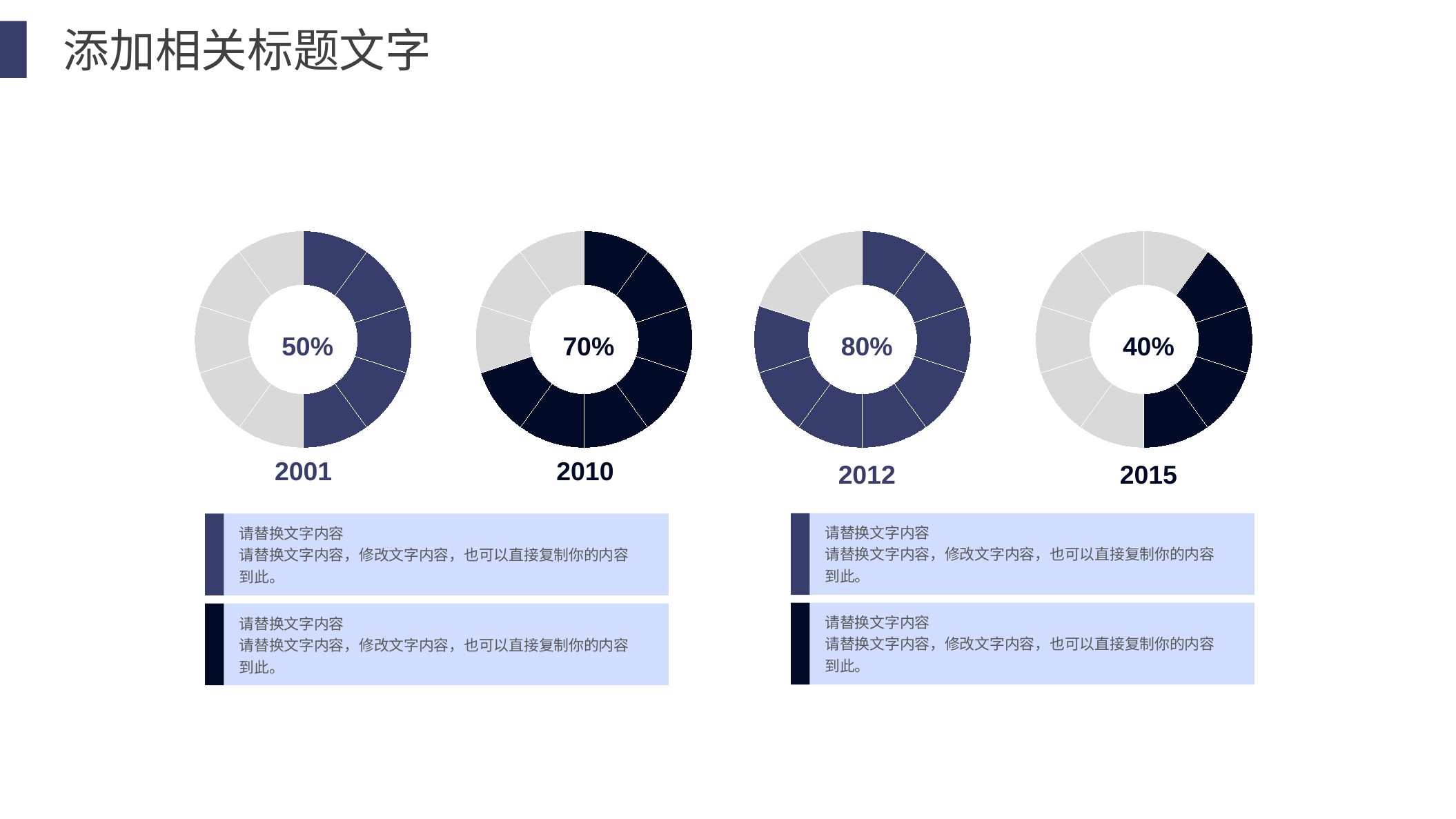
Which year's donut chart shows the lowest percentage? 2015 How many donut charts are on the slide? 4 What percentage is shown in the centre of the donut chart labelled 2015? 40% What percentage is shown in the centre of the donut chart labelled 2001? 50% What is the difference between the percentage shown for 2012 and the percentage shown for 2001? 30% Do the percentages rise or fall from the 2012 donut chart to the 2015 donut chart? Fall What percentage is shown in the centre of the donut chart labelled 2012? 80% Which year's donut chart shows the highest percentage? 2012 What percentage is shown in the centre of the donut chart labelled 2010? 70% Which shows a larger percentage, the 2010 donut chart or the 2015 donut chart? 2010 What kind of chart is used to show the percentage for each year? Donut chart What is the difference between the percentage shown for 2010 and the percentage shown for 2015? 30%